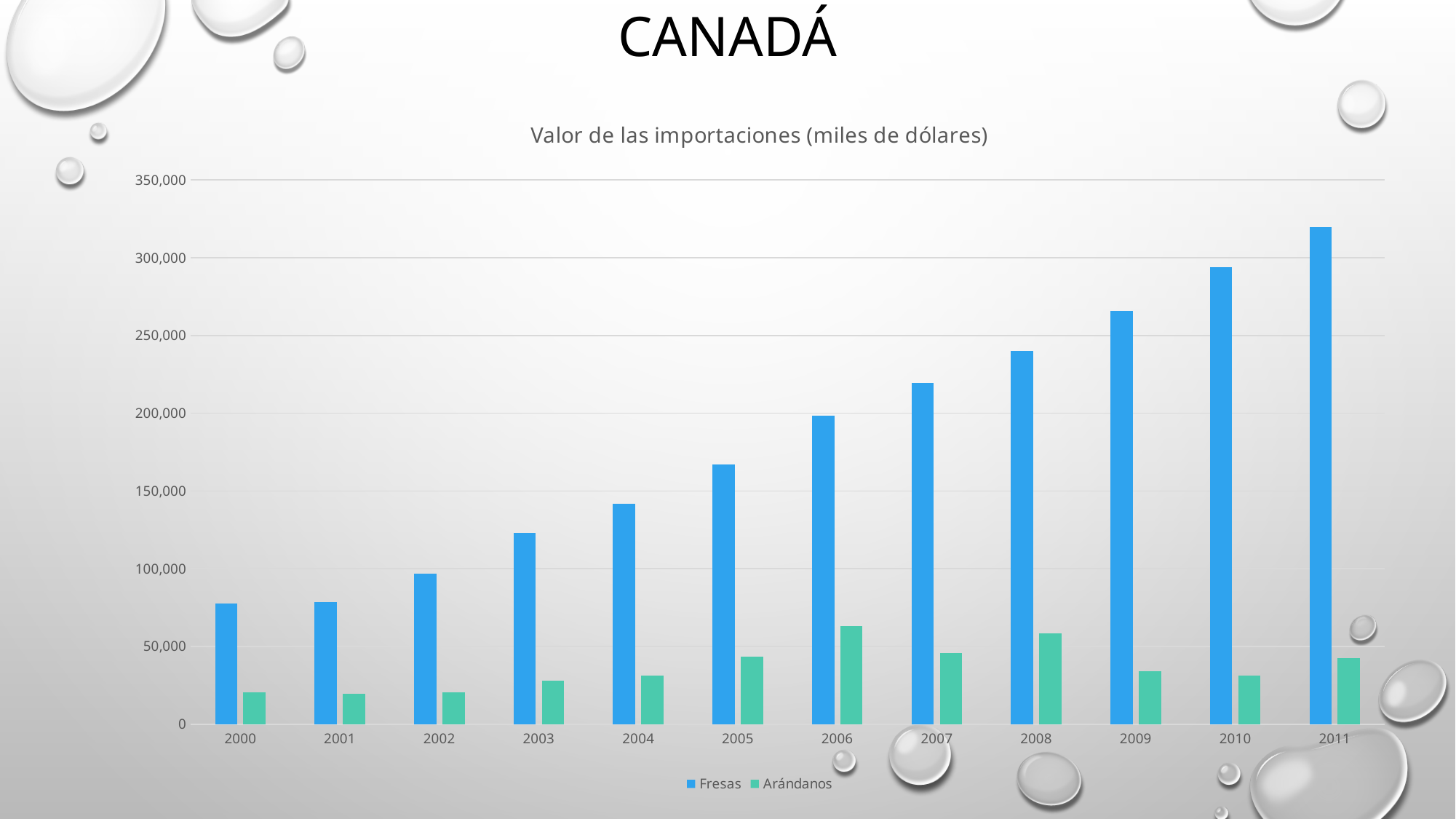
Is the value for Arándanos in 2009 greater or less than 50,000? less Is the value for Fresas in 2011 greater or less than 300,000? greater What is the title of the chart? Valor de las importaciones (miles de dólares) Is the value for Fresas in 2005 greater or less than 150,000? greater In which year is the value for Fresas highest? 2011 How many series does the legend list? 2 Which is larger for Arándanos, the value in 2006 or the value in 2009? 2006 Do the values for Fresas generally rise or fall from 2000 to 2011? rise Which is larger in 2005, the value for Fresas or the value for Arándanos? Fresas What kind of chart is shown on the slide? bar chart How many years are shown on the x axis? 12